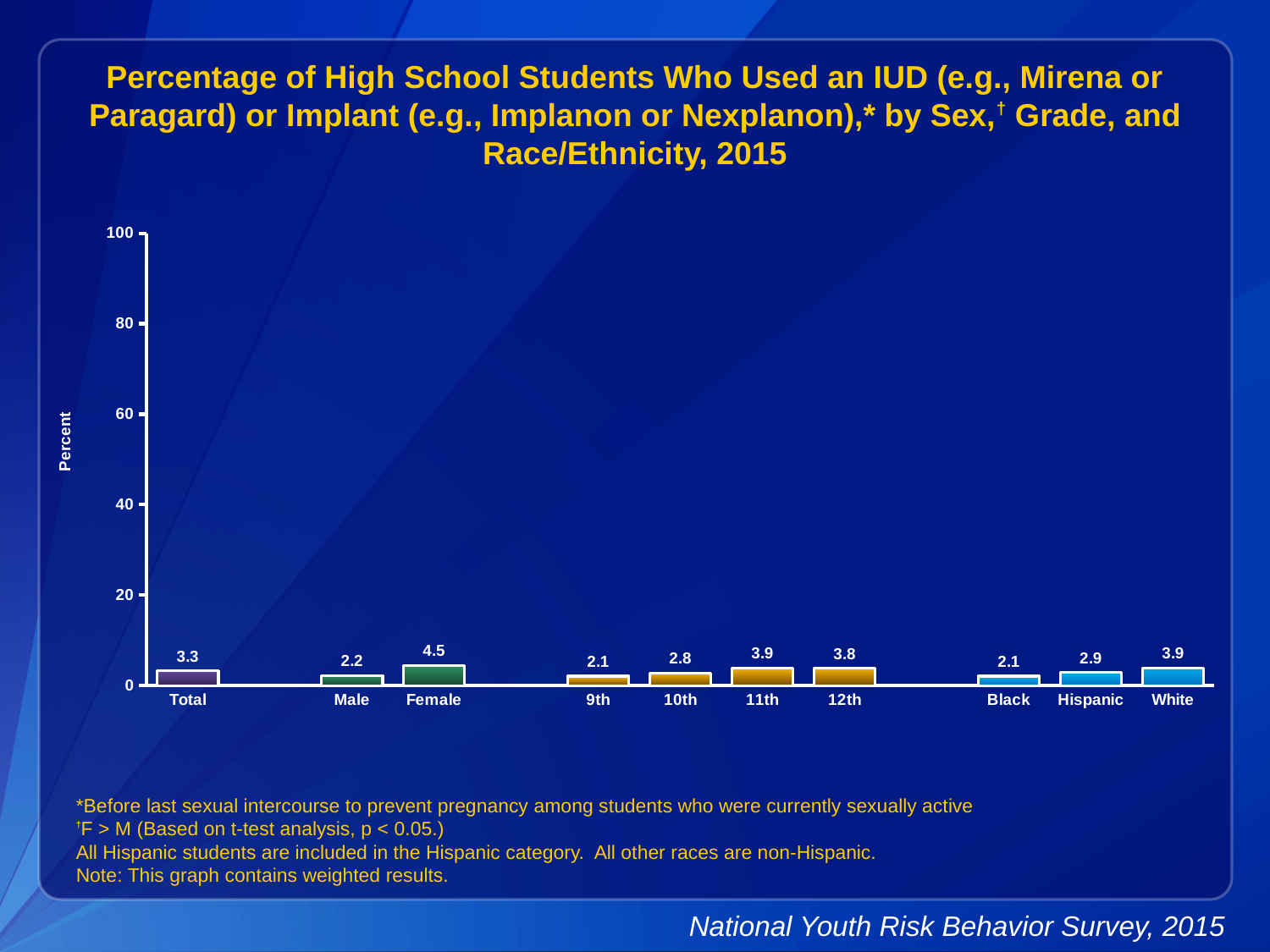
What is the value for 9th grade? 2.1 Which category has the highest value? Female What is the label on the y axis? Percent Which is larger, the value for 10th grade or the value for 12th grade? 12th How many categories are shown on the x axis? 10 What is the value for Total? 3.3 What is the value for Female? 4.5 What is the value for Hispanic students? 2.9 What kind of chart is shown on the slide? bar chart Which grade has the lowest value? 9th Is the value for White greater or less than 20? less What is the difference between the Female and Male values? 2.3